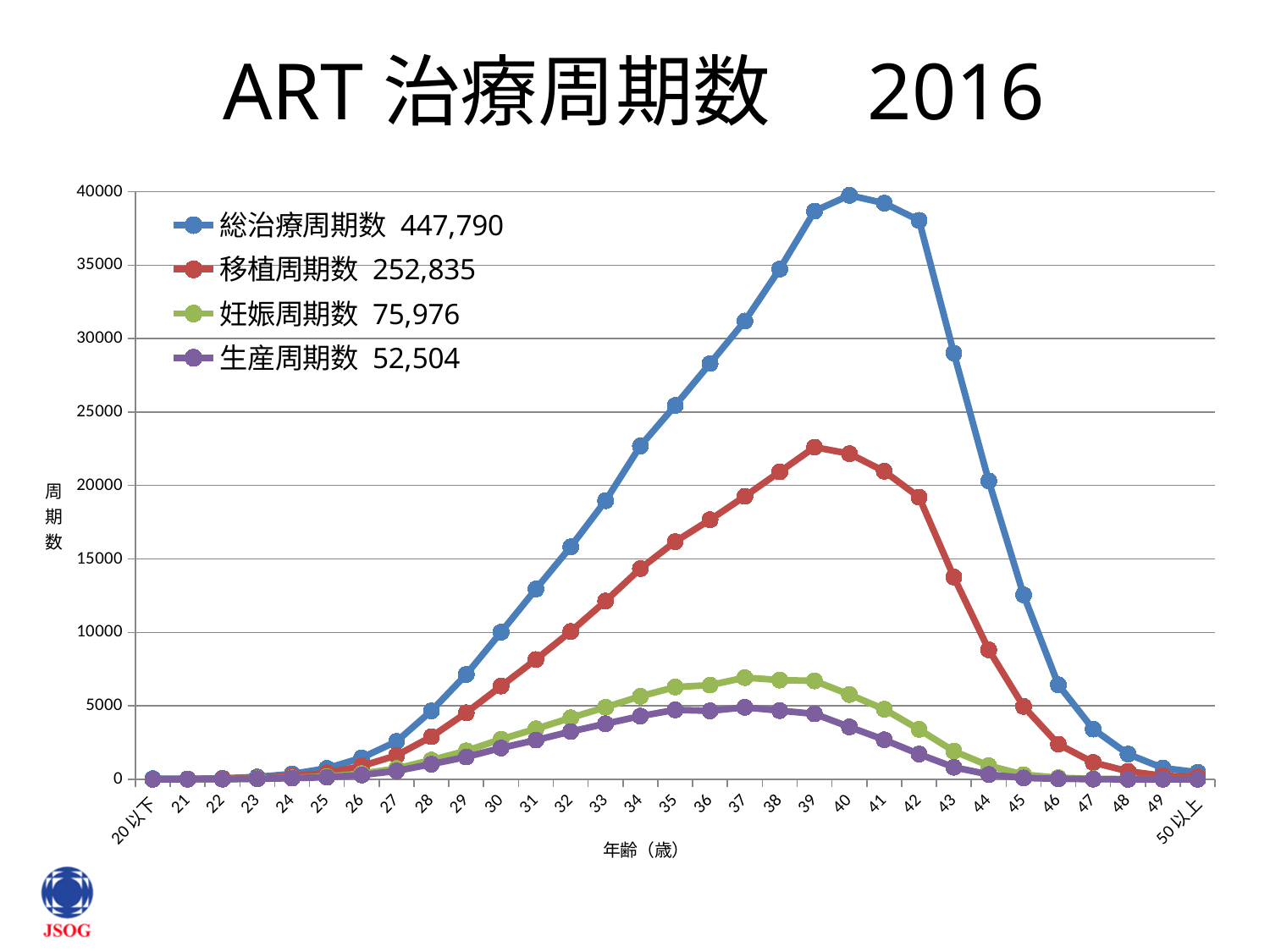
What kind of chart is shown on the slide? line chart Which series has the largest total shown in the legend? 総治療周期数 What total is printed in the legend for 妊娠周期数? 75,976 How many series does the legend list? 4 Is the value of 移植周期数 at age 39 greater or less than 20000? greater Does the 総治療周期数 line rise or fall from age 40 to 50以上? fall Is the value of 総治療周期数 at age 40 greater or less than 35000? greater What is the difference between the legend totals for 総治療周期数 and 移植周期数? 194,955 How many age categories are shown along the x axis? 31 What total is printed in the legend for 総治療周期数? 447,790 Which series has the smallest total shown in the legend? 生産周期数 Which legend total is larger, 移植周期数 or 妊娠周期数? 移植周期数